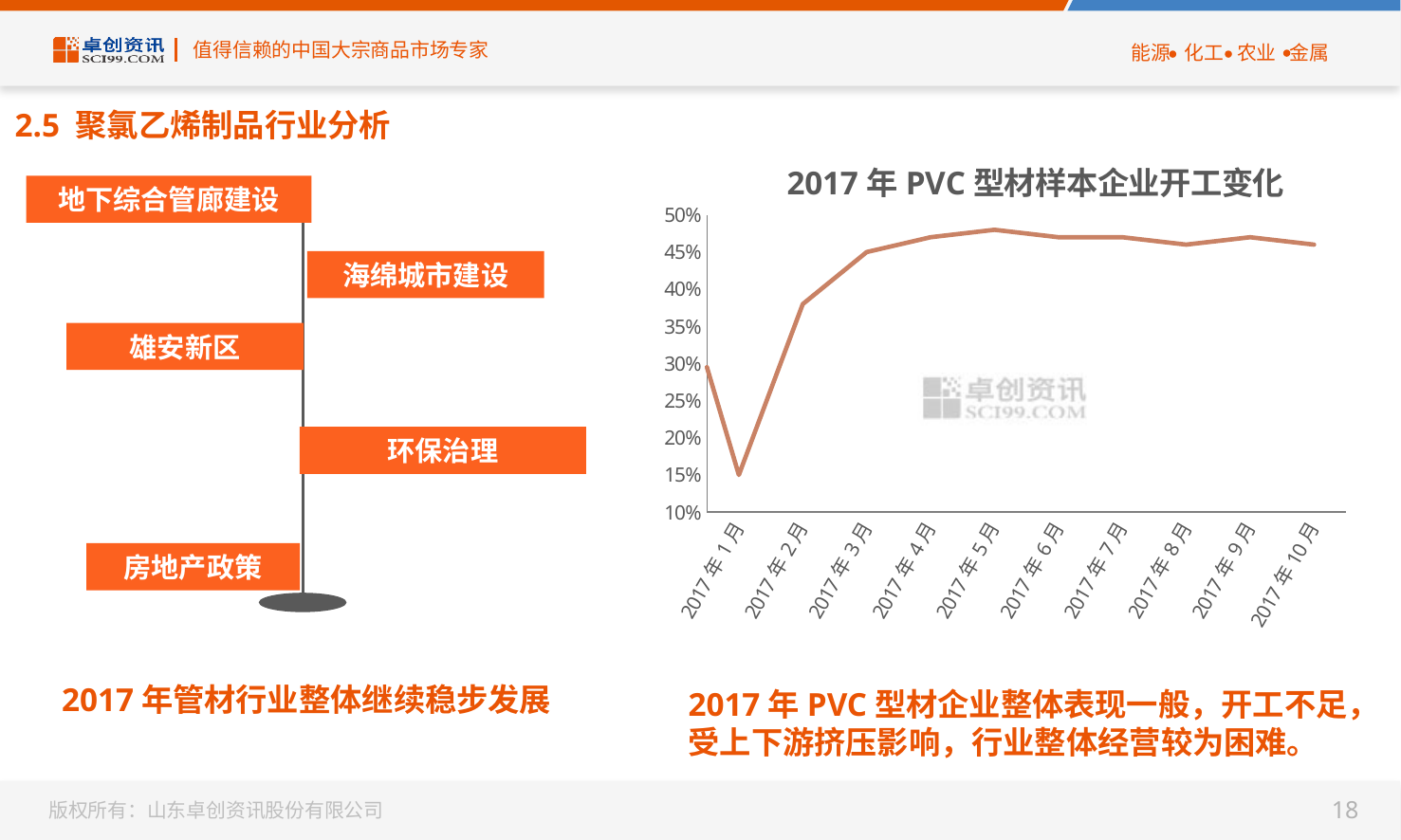
What is the highest tick value shown on the y axis of the chart? 50% Which is larger, the value for 2017年1月 or the value for 2017年10月? 2017年10月 Which is larger, the value for 2017年7月 or the value for 2017年1月? 2017年7月 Is the value for 2017年5月 greater or less than 40%? greater Is the value for 2017年8月 greater or less than 30%? greater What kind of chart is shown on the slide? line chart Overall, does the line rise or fall from 2017年1月 to 2017年10月? rise Is the highest point on the line greater or less than 50%? less What is the title of the chart on the slide? 2017年PVC型材样本企业开工变化 How many months are labelled on the x axis of the chart? 10